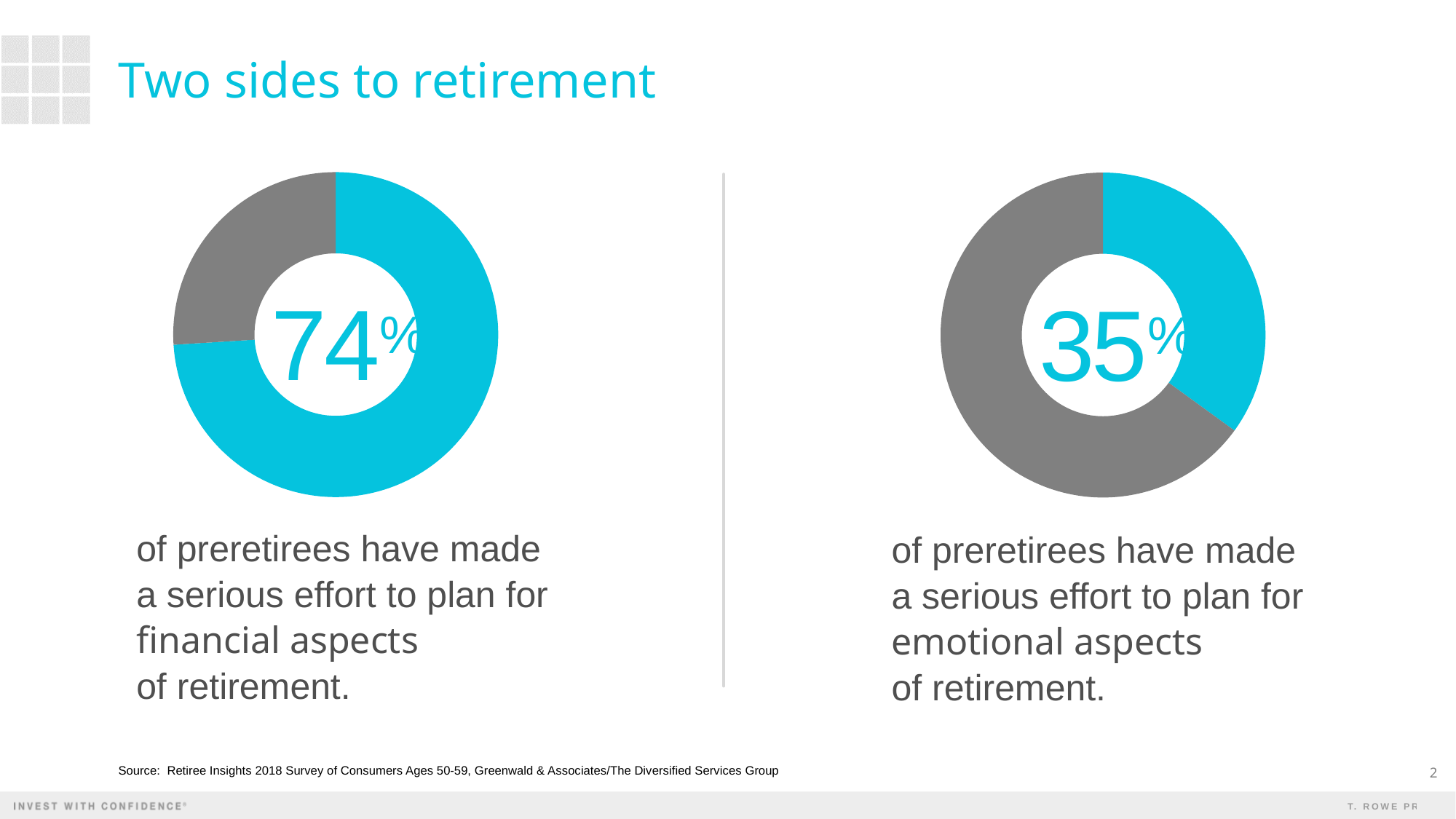
What is the difference in percentage points between the left chart's value (74%) and the right chart's value (35%)? 39 percentage points In the left chart, is the highlighted blue share greater or less than 50%? greater What colour is used for the highlighted slice in both charts? Blue (cyan) What is the title of the slide containing the two charts? Two sides to retirement In the left chart, what percentage of preretirees have made a serious effort to plan for financial aspects of retirement? 74% Which is larger: the percentage who planned for financial aspects (left chart) or the percentage who planned for emotional aspects (right chart)? Financial aspects (74%) In the right chart, what percentage of preretirees have made a serious effort to plan for emotional aspects of retirement? 35% Which chart shows the higher percentage, the left (financial aspects) or the right (emotional aspects)? Left (financial aspects) What kind of chart is used on this slide? Pie (donut) chart In the right chart, what aspect of retirement planning does the 35% refer to? Emotional aspects of retirement In the right chart, is the highlighted blue share greater or less than 50%? less How many charts are shown on the slide? 2